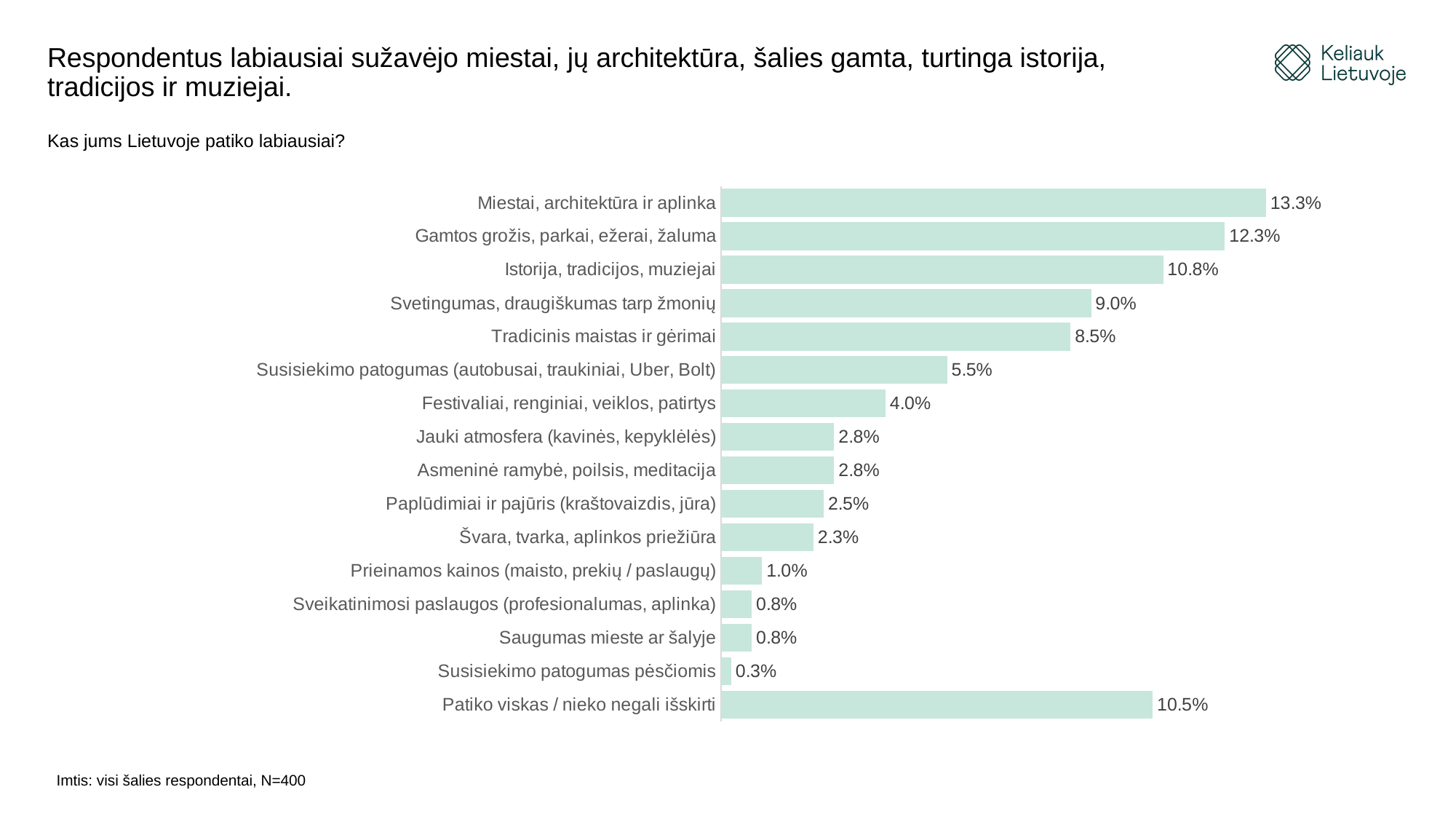
What is the difference between the values for "Gamtos grožis, parkai, ežerai, žaluma" and "Istorija, tradicijos, muziejai"? 1.5% What is the value for "Patiko viskas / nieko negali išskirti"? 10.5% Which category has the highest value? Miestai, architektūra ir aplinka What is the value for "Susisiekimo patogumas (autobusai, traukiniai, Uber, Bolt)"? 5.5% Which is larger: the value for "Svetingumas, draugiškumas tarp žmonių" or the value for "Festivaliai, renginiai, veiklos, patirtys"? Svetingumas, draugiškumas tarp žmonių Which category has the lowest value? Susisiekimo patogumas pėsčiomis What kind of chart is shown on the slide? Bar chart What question is the chart based on, as written above it? Kas jums Lietuvoje patiko labiausiai? How many categories are shown in the chart? 16 What is the value for "Tradicinis maistas ir gėrimai"? 8.5% What is the value for "Miestai, architektūra ir aplinka"? 13.3% What is the difference between the values for "Paplūdimiai ir pajūris (kraštovaizdis, jūra)" and "Prieinamos kainos (maisto, prekių / paslaugų)"? 1.5%